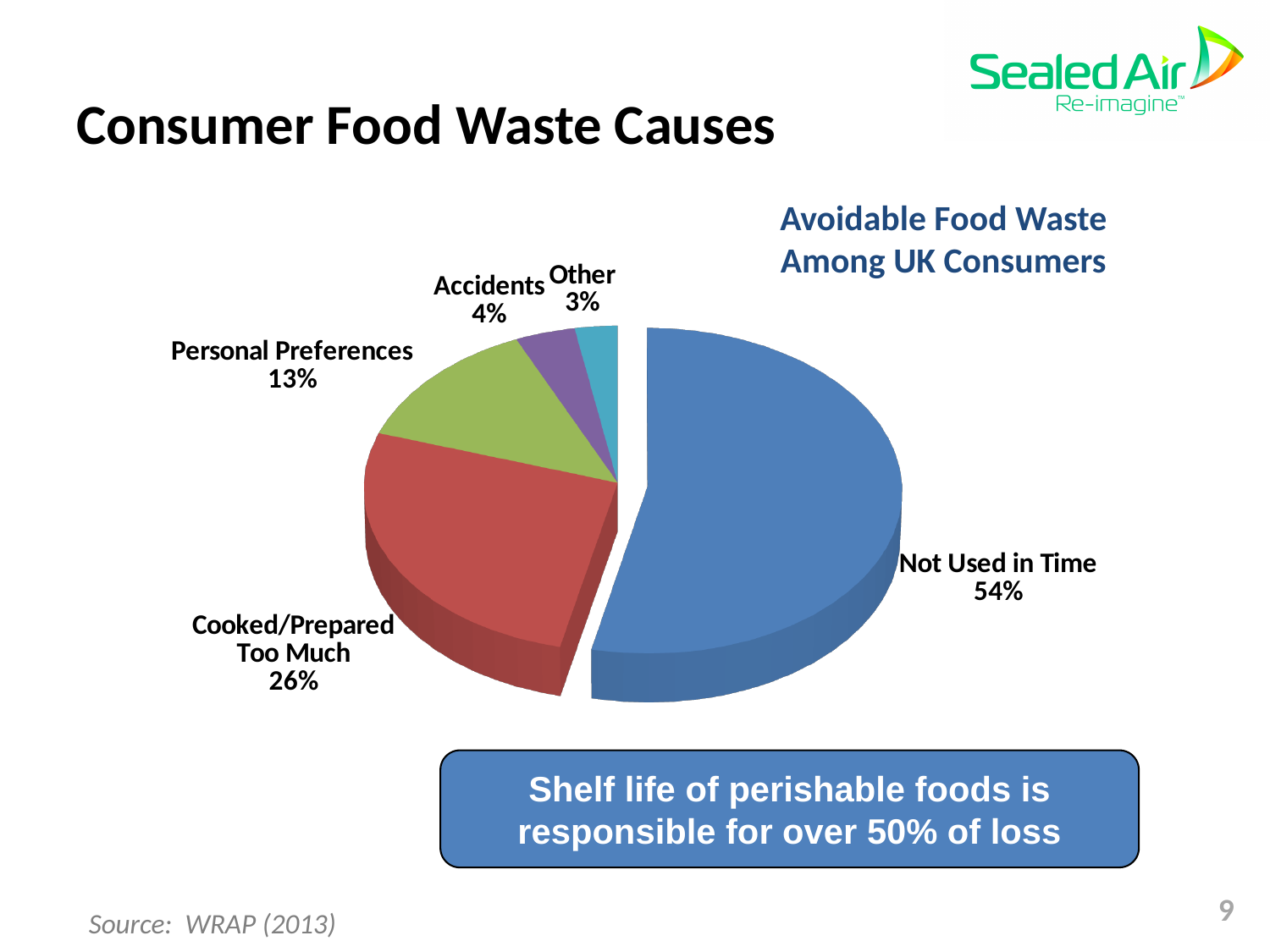
What is the title of the chart? Avoidable Food Waste Among UK Consumers Which is larger, the share for Personal Preferences or the share for Accidents? Personal Preferences What percentage is shown for Accidents? 4% What colour is the Not Used in Time slice? Blue What is the difference in percentage points between Not Used in Time and Cooked/Prepared Too Much? 28 How many categories are shown in the pie chart? 5 What type of chart is shown on the slide? Pie chart What percentage of avoidable food waste is due to Cooked/Prepared Too Much? 26% What share of avoidable food waste is attributed to Not Used in Time? 54% What is the value shown for Personal Preferences? 13% Which cause accounts for the smallest share of avoidable food waste? Other Which cause accounts for the largest share of avoidable food waste? Not Used in Time